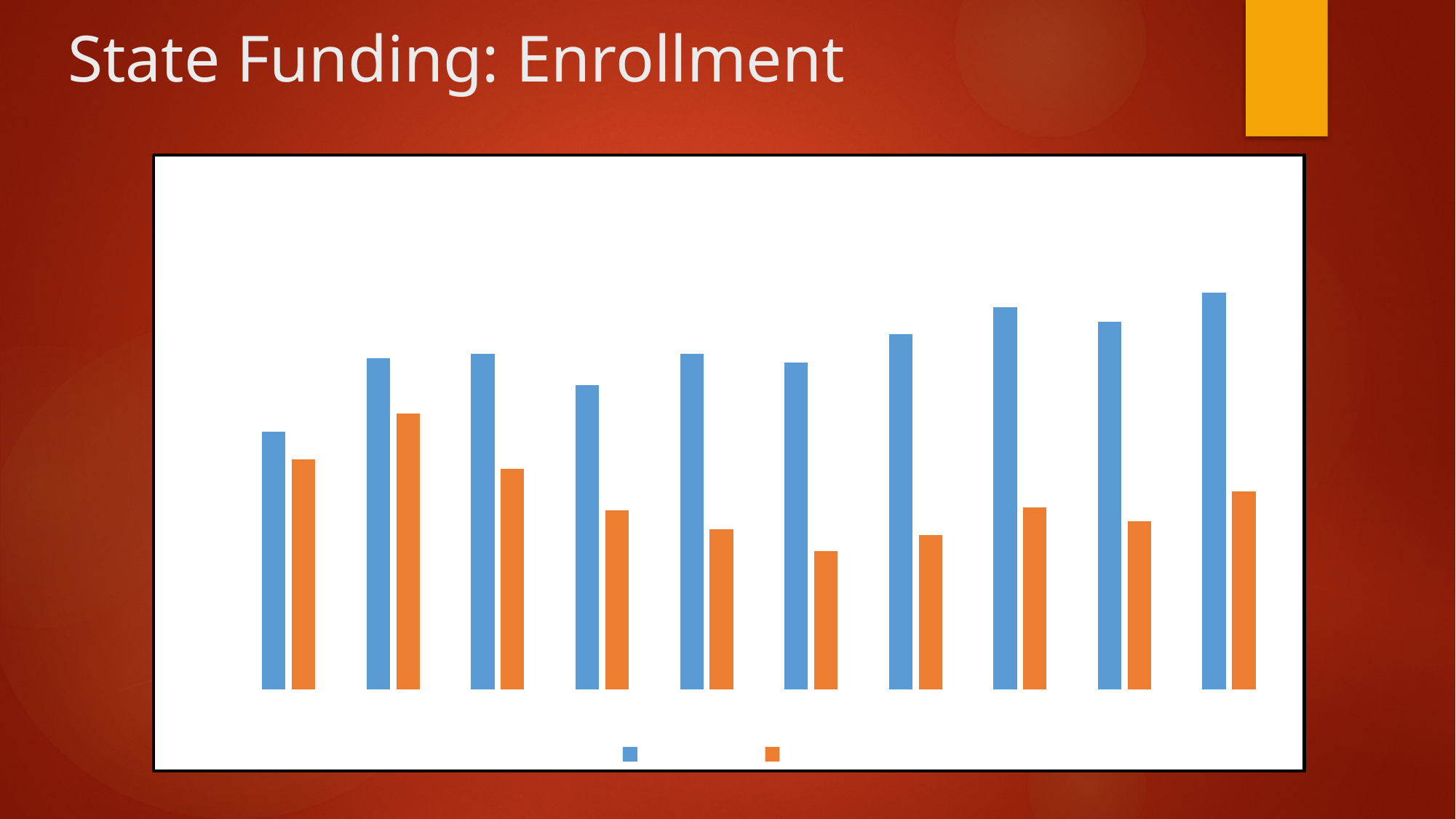
In each group of bars, which bar is taller, the blue one or the orange one? the blue one What kind of chart is shown on the slide? bar chart How many groups of bars (categories) are plotted in the chart? 10 Are the bars in the chart vertical or horizontal? vertical How many series does the chart's legend show? 2 What two colours are used for the bars in the chart? blue and orange